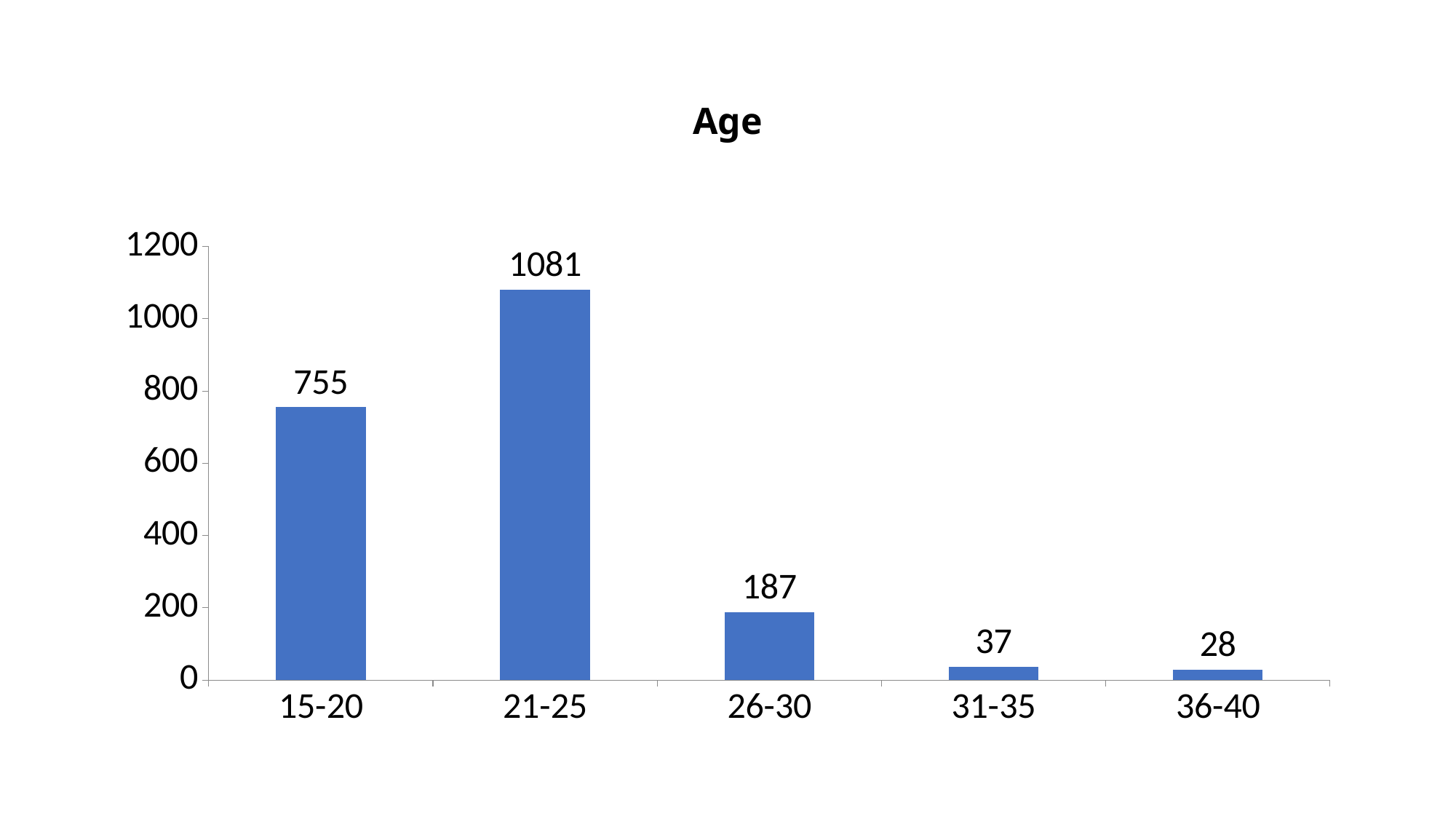
What is the difference between the values for 21-25 and 15-20? 326 How many age groups are shown on the chart? 5 Which is larger, the value for 15-20 or the value for 26-30? 15-20 What is the title of the chart? Age What is the difference between the values for 26-30 and 31-35? 150 What is the value for the 26-30 age group? 187 What is the value for the 15-20 age group? 755 What is the value for the 21-25 age group? 1081 What kind of chart is shown on the slide? Bar chart Which age group has the lowest value? 36-40 Which age group has the highest value? 21-25 What is the value for the 36-40 age group? 28